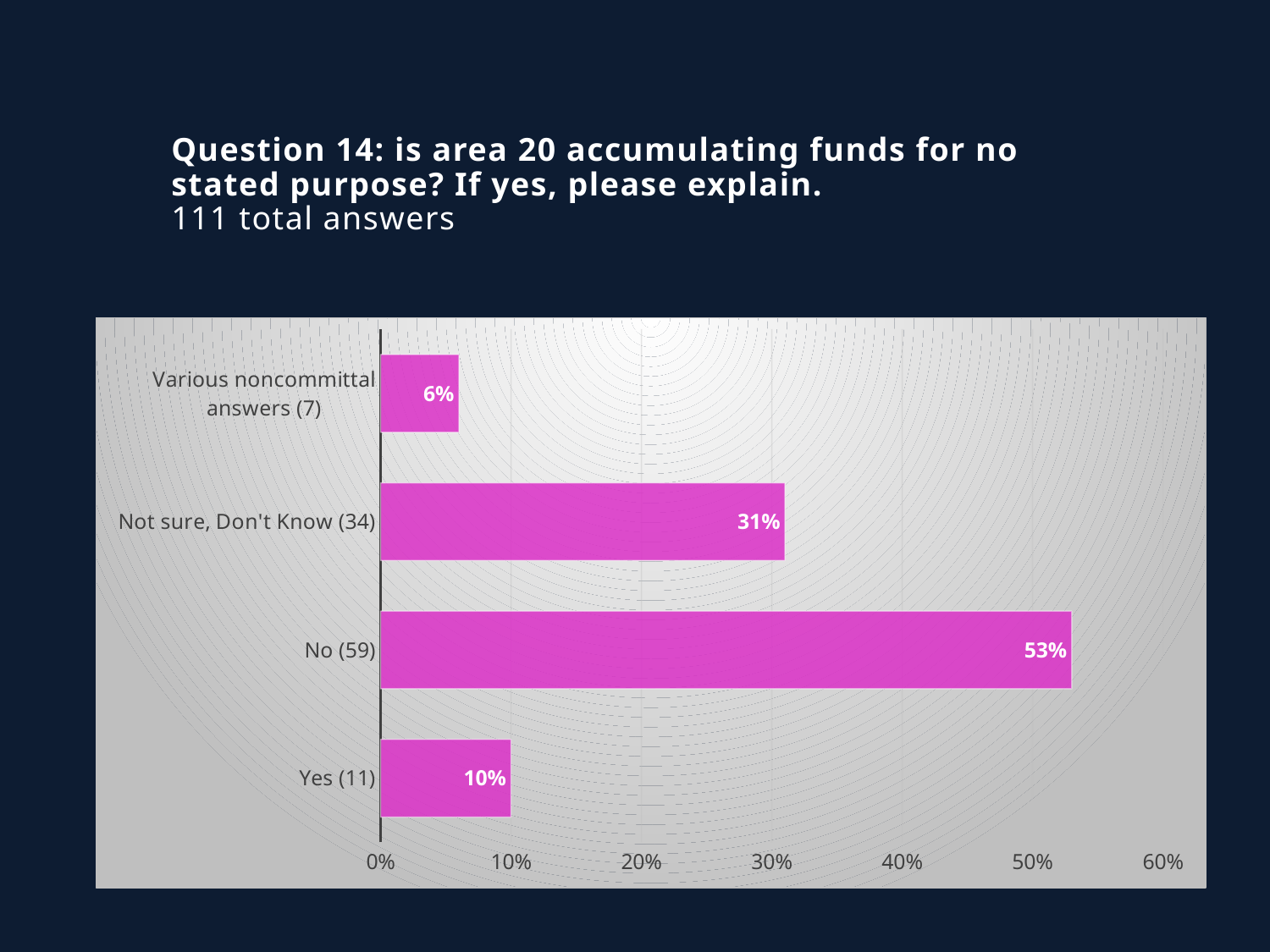
What kind of chart is shown on the slide? Bar chart What percentage is shown for "Various noncommittal answers (7)"? 6% Which is larger, the value for "Yes (11)" or the value for "Various noncommittal answers (7)"? Yes (11) What is the difference in percentage points between "No (59)" and "Not sure, Don't Know (34)"? 22 What percentage is shown for the "No (59)" category? 53% How many categories are shown in the chart? 4 Is the value for "No (59)" greater or less than 50%? greater Which category has the lowest percentage? Various noncommittal answers (7) What percentage is shown for "Not sure, Don't Know (34)"? 31% Which category has the highest percentage? No (59) What percentage is shown for the "Yes (11)" category? 10% How many total answers does the slide report for Question 14? 111